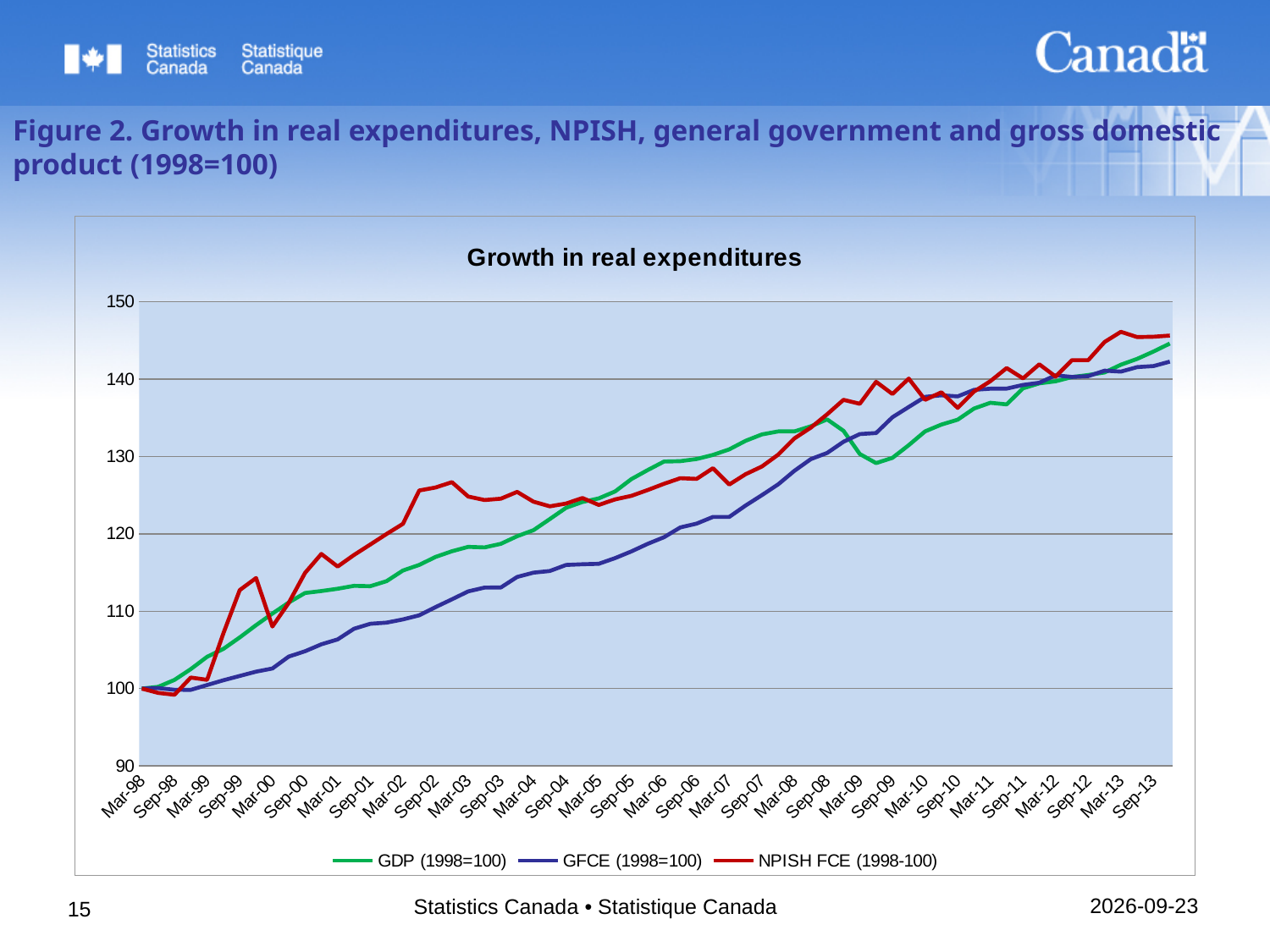
Does the GFCE (1998=100) series generally rise or fall from Mar-98 to Sep-13? rise What kind of chart is shown on the slide? line chart Which series has the lowest value at Sep-13? GFCE (1998=100) At Sep-09, which series is higher: GFCE (1998=100) or GDP (1998=100)? GFCE (1998=100) Is the value of NPISH FCE (1998-100) at Sep-99 greater or less than 110? greater At Sep-02, which series is higher: NPISH FCE (1998-100) or GFCE (1998=100)? NPISH FCE (1998-100) What is the title printed inside the chart area? Growth in real expenditures Is the value of GDP (1998=100) at Mar-05 greater or less than 130? less Is the value of GFCE (1998=100) at Sep-13 greater or less than 140? greater What is the value of the GDP (1998=100) series at Mar-98? 100 What are the three series named in the legend? GDP (1998=100), GFCE (1998=100), NPISH FCE (1998-100) How many series does the chart's legend list? 3